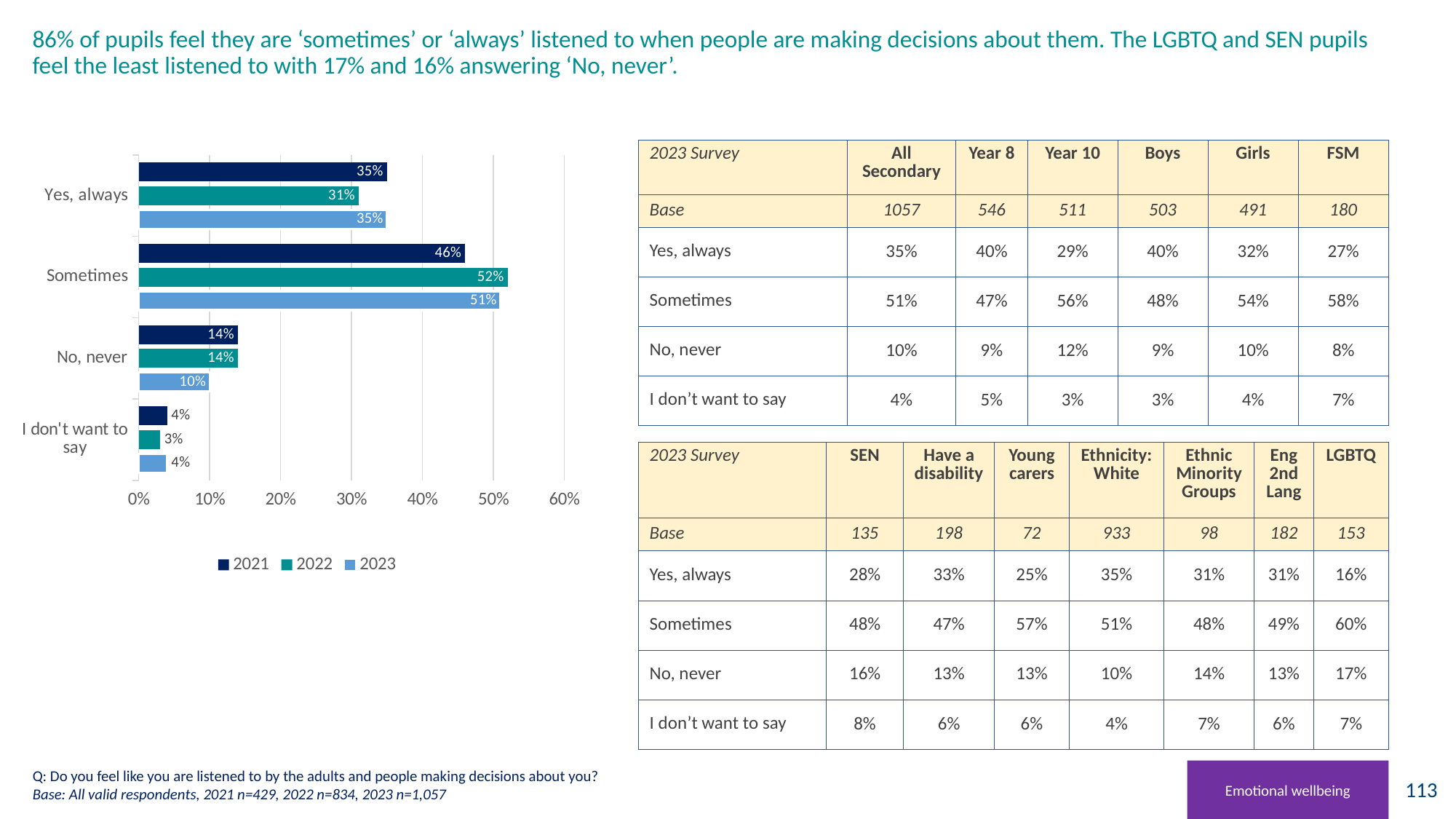
What is the difference between the 2022 and 2021 values for 'Sometimes' in the bar chart? 6% How many series does the legend of the bar chart list? 3 What is the 2022 value for 'No, never' in the bar chart? 14% Which category has the highest 2022 value in the bar chart? Sometimes Is the 2023 value for 'Sometimes' greater or less than 40%? greater What kind of chart is shown on the slide? Bar chart What is the 2021 value for 'Yes, always' in the bar chart? 35% Which years are listed in the legend of the bar chart? 2021, 2022, 2023 Which category has the lowest 2023 value in the bar chart? I don't want to say How many response categories are shown in the bar chart? 4 Is the 2021 value for 'Yes, always' or the 2022 value for 'Yes, always' larger in the bar chart? 2021 What is the 2023 value for 'Sometimes' in the bar chart? 51%